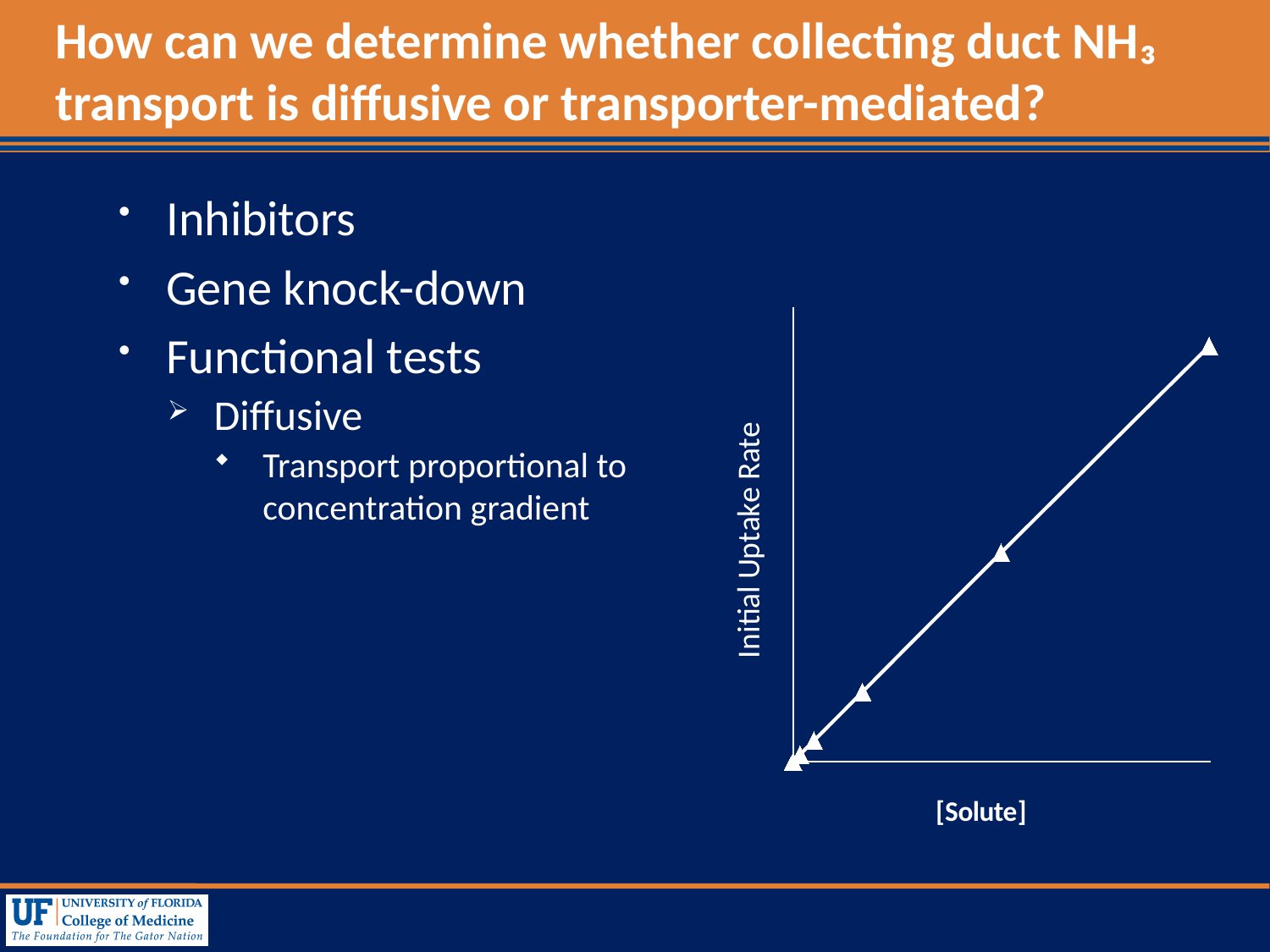
What is the label on the y axis of the chart? Initial Uptake Rate What kind of chart is shown on the slide? line chart Does the Initial Uptake Rate rise or fall as [Solute] increases along the x axis? rise What is the label on the x axis of the chart? [Solute]